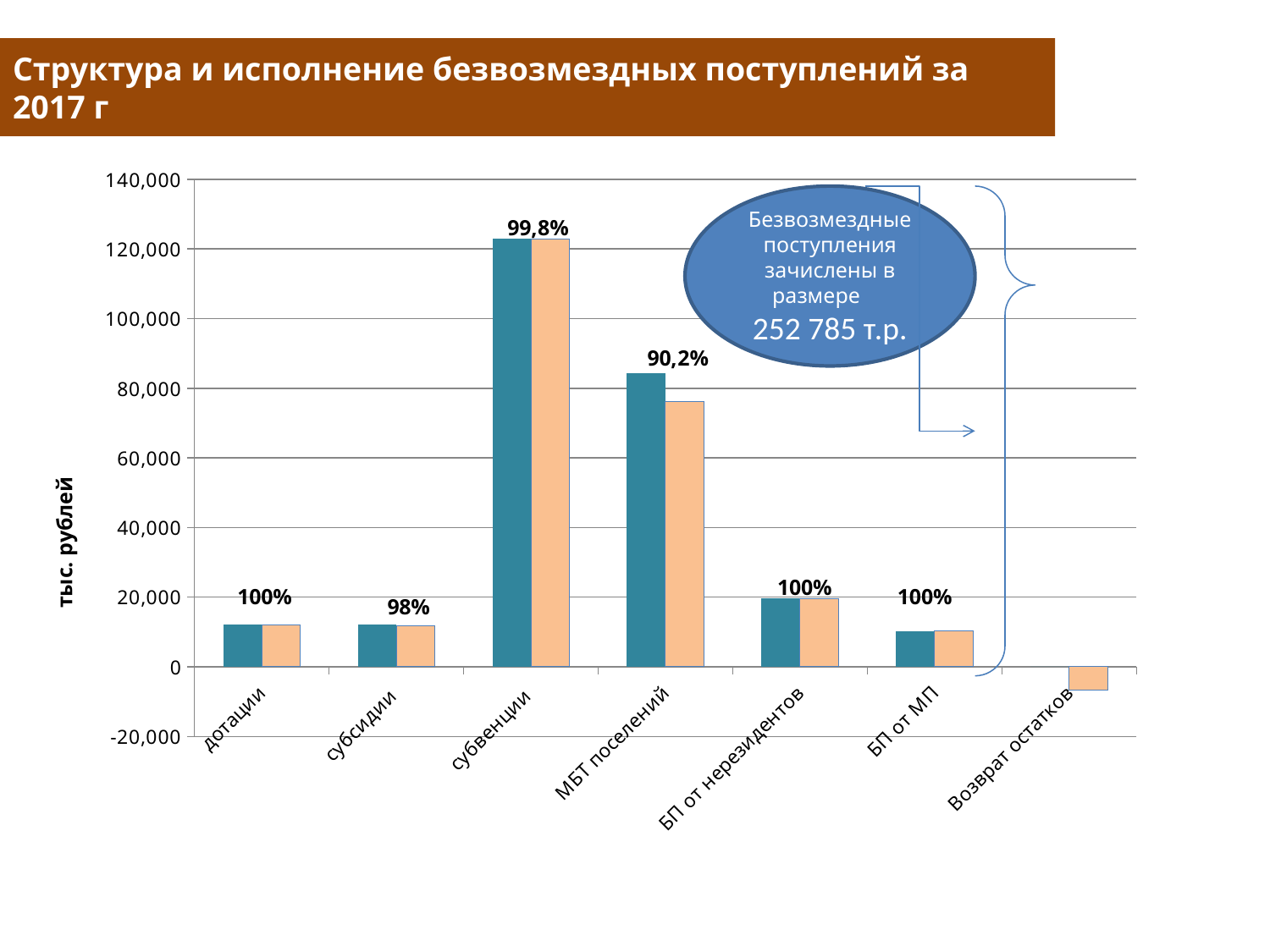
Which category has the tallest bars in the chart? субвенции Is the value of the first (teal) bar for МБТ поселений greater or less than 80,000? greater What percentage label is shown above the bars for МБТ поселений? 90,2% What kind of chart is shown on the slide? bar chart What percentage label is shown above the bars for субсидии? 98% Is the value of the first (teal) bar for субвенции greater or less than 120,000? greater Which category has the lowest percentage label in the chart? МБТ поселений How many categories are shown on the x axis of the chart? 7 Which category has bars that are taller: субвенции or МБТ поселений? субвенции What percentage label is shown above the bars for субвенции? 99,8% What percentage label is shown above the bars for дотации? 100% What is the label of the vertical axis of the chart? тыс. рублей